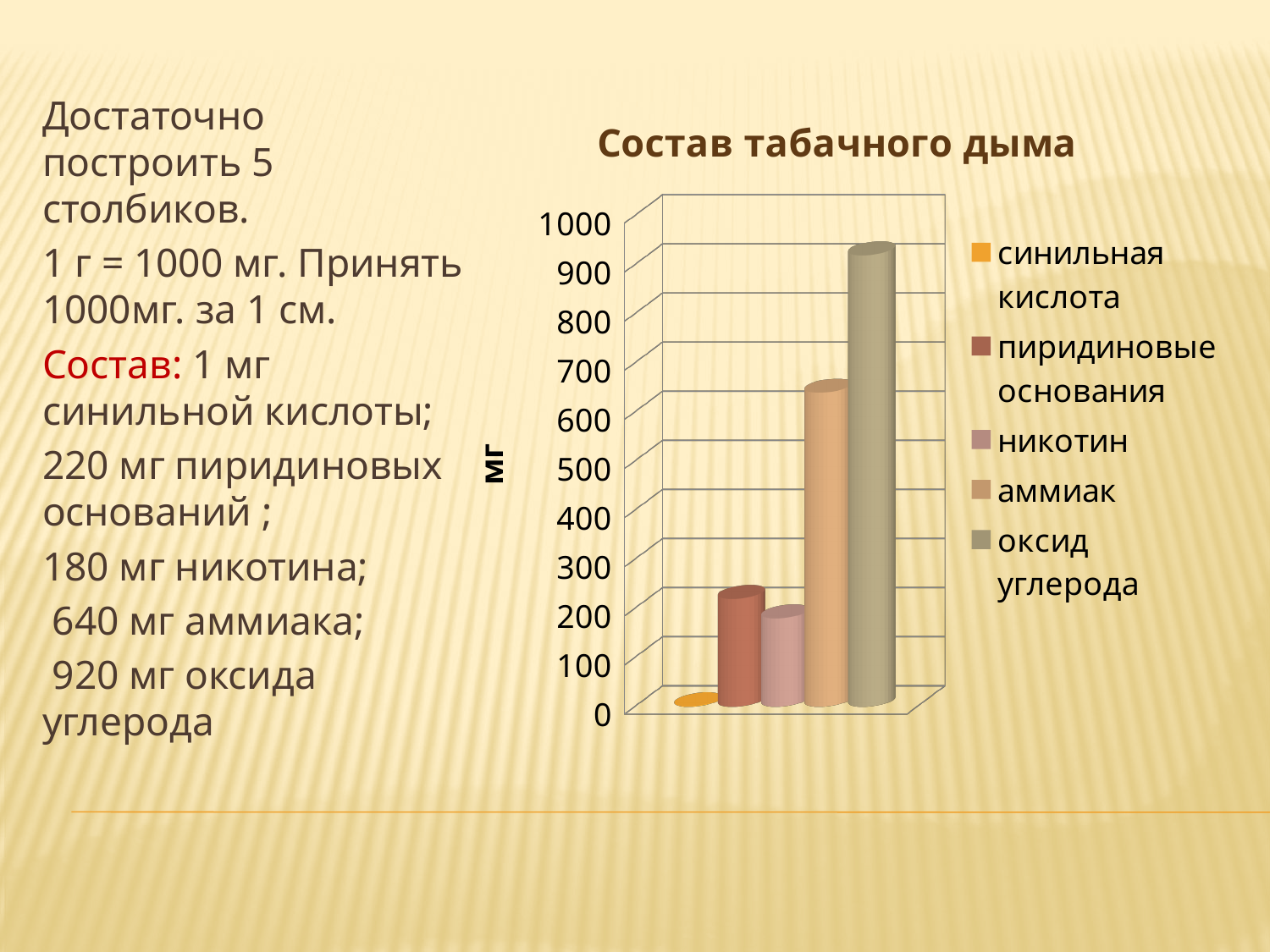
Which bar is taller, аммиак or оксид углерода? оксид углерода What is the title of the chart? Состав табачного дыма Which component has the tallest bar in the chart? оксид углерода Is the value for никотин greater or less than 200? less What kind of chart is shown on the slide? bar chart Is the value for оксид углерода greater or less than 900? greater Which bar is taller, пиридиновые основания or никотин? пиридиновые основания How many bars are plotted in the chart? 5 Is the value for аммиак greater or less than 600? greater How many entries does the chart legend list? 5 What unit is shown on the vertical axis label of the chart? мг Which component has the smallest bar in the chart? синильная кислота